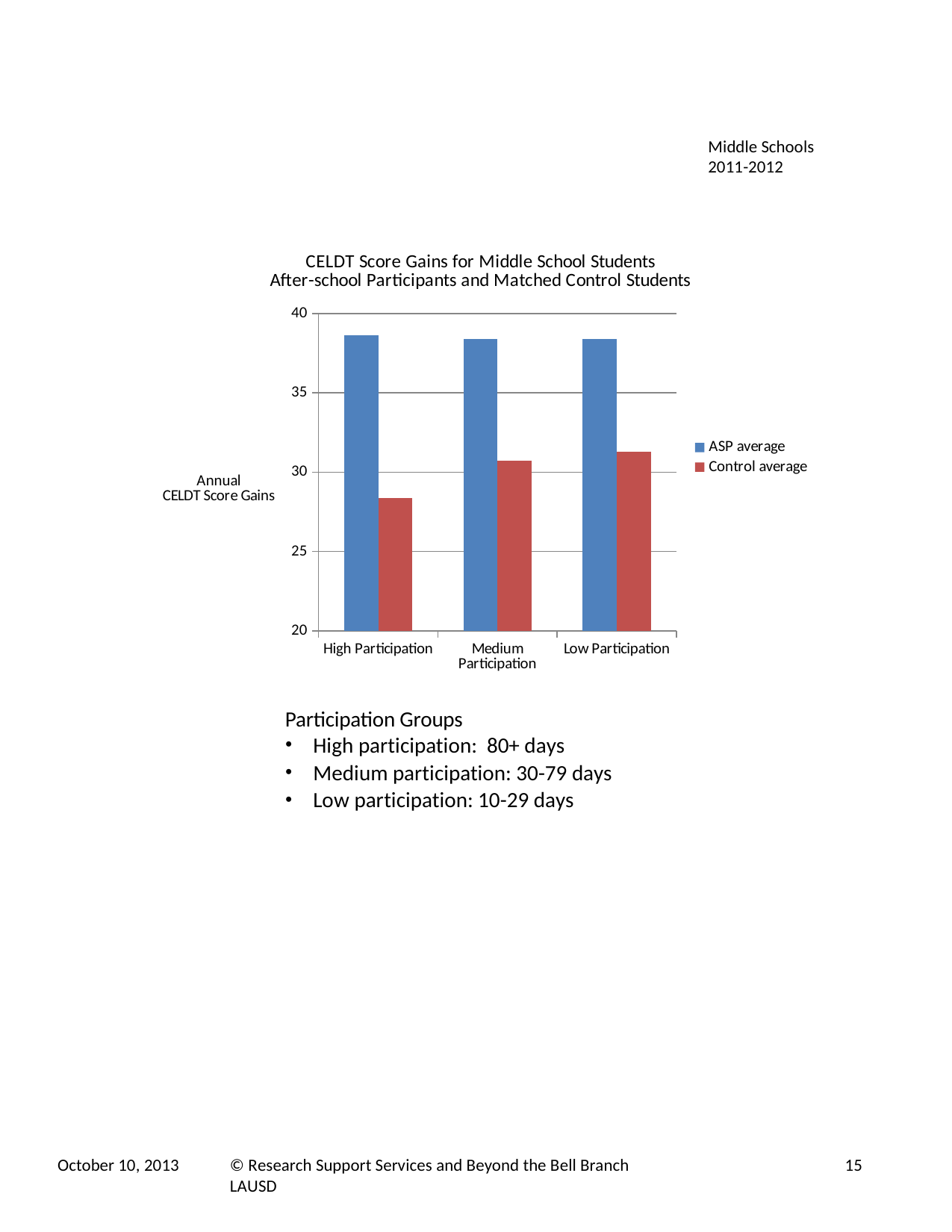
For High Participation, which is larger: the ASP average or the Control average? ASP average How many series does the chart's legend list? 2 What kind of chart is shown on the slide? bar chart Is the Control average for High Participation greater or less than 30? less Which series is shown in red in the chart? Control average How many participation groups are shown on the x axis of the chart? 3 What is the label on the vertical axis of the chart? Annual CELDT Score Gains Does the Control average rise or fall moving from High Participation to Low Participation along the x axis? rise Which participation group has the lowest Control average? High Participation Is the Control average for Low Participation greater or less than 30? greater Is the ASP average for High Participation greater or less than 35? greater